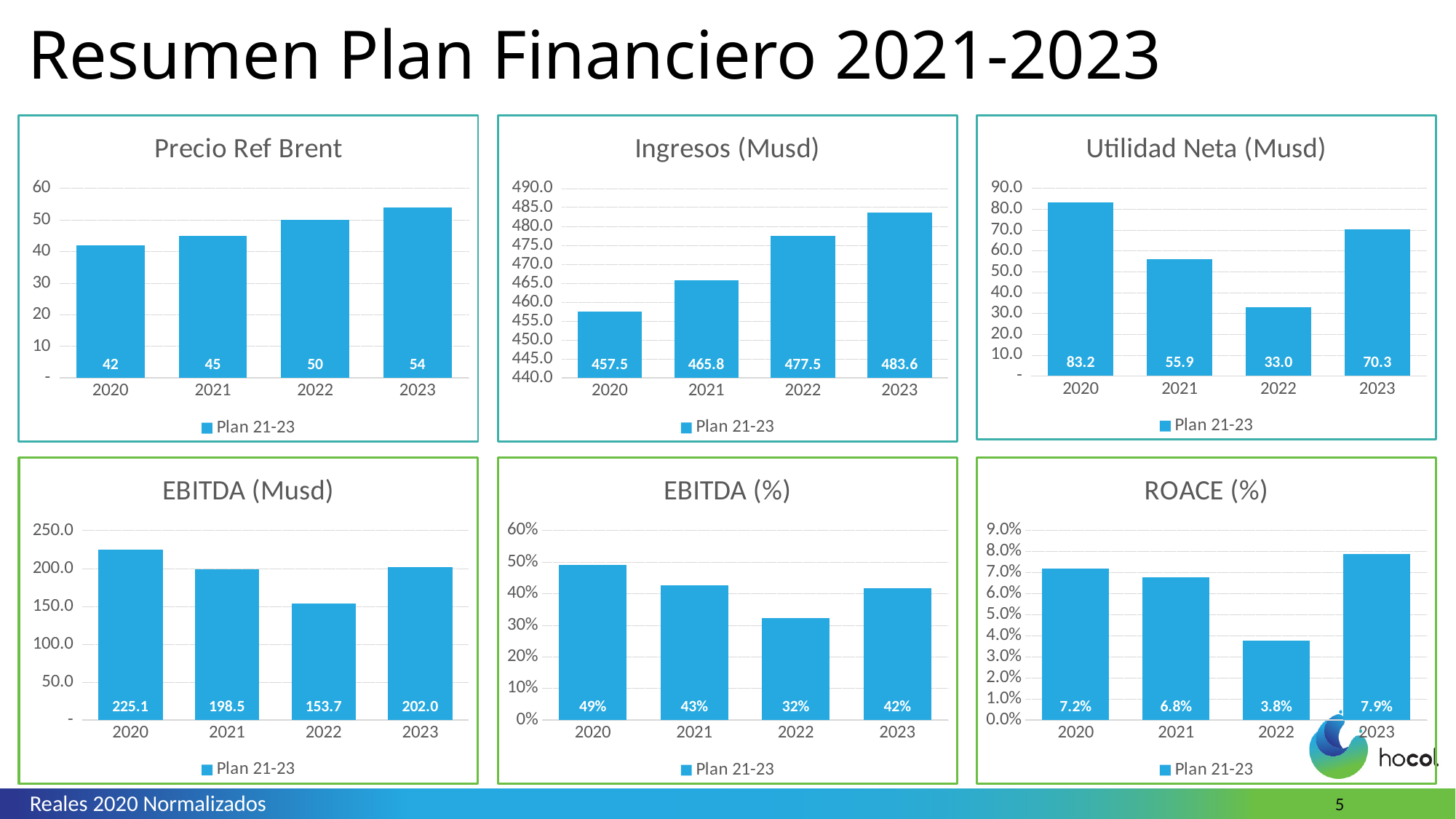
In the 'ROACE (%)' chart, what is the difference between the 2020 and 2022 values? 3.4% In the 'Utilidad Neta (Musd)' chart, which year has the lowest value? 2022 In the 'EBITDA (%)' chart, is the value for 2021 larger or smaller than the value for 2023? larger In the 'Utilidad Neta (Musd)' chart, what is the difference between the 2020 and 2023 values? 12.9 In the 'Precio Ref Brent' chart, do the values rise or fall from 2020 to 2023? rise In the 'Precio Ref Brent' chart, what is the value for 2023? 54 How many years are shown on the x axis of the 'Ingresos (Musd)' chart? 4 In the 'EBITDA (Musd)' chart, what is the value for 2022? 153.7 In the 'EBITDA (Musd)' chart, which year has the highest value? 2020 In the 'ROACE (%)' chart, what is the value for 2023? 7.9% In the 'Ingresos (Musd)' chart, what is the value for 2021? 465.8 What kind of chart is the 'EBITDA (%)' chart? bar chart